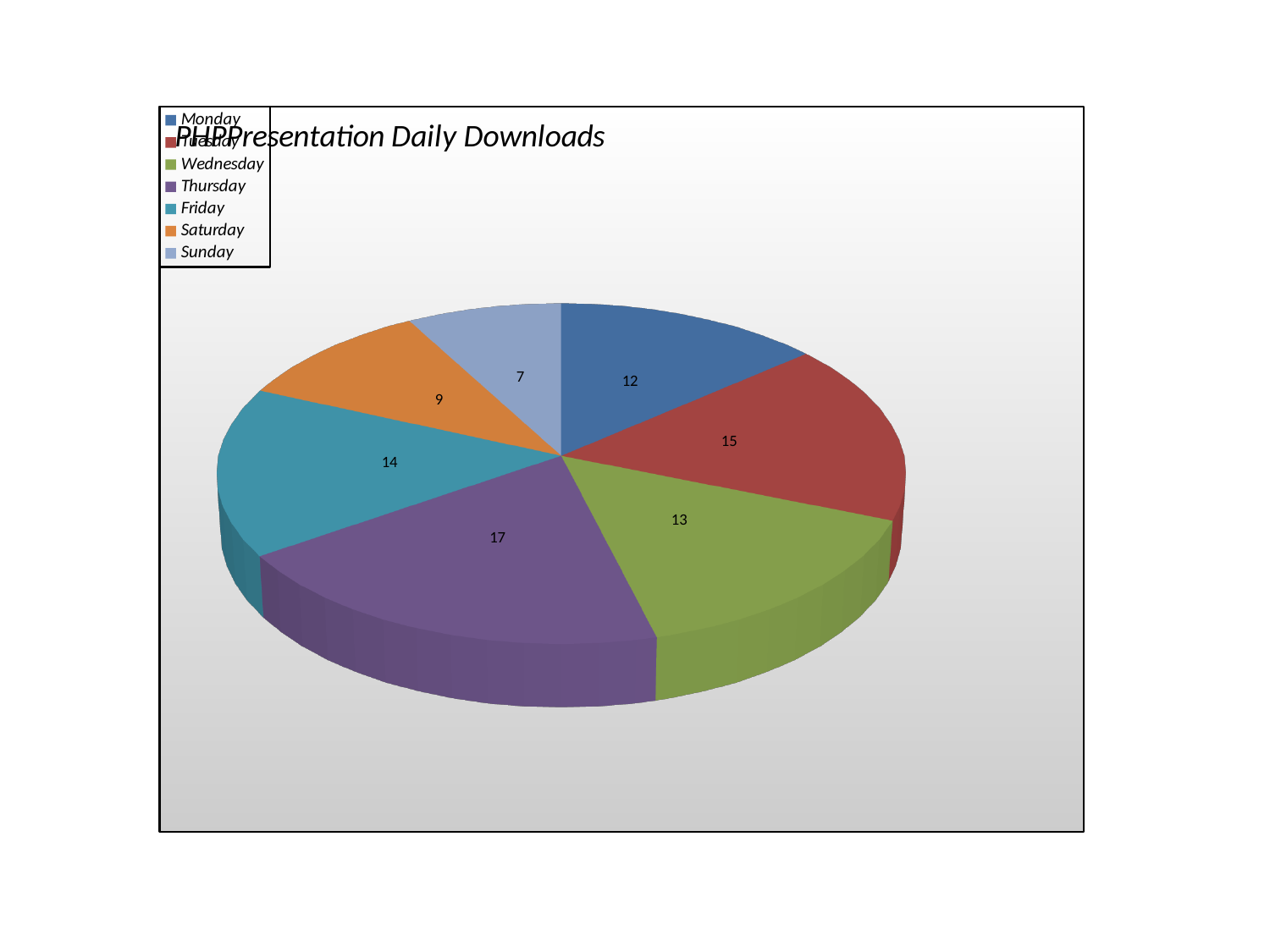
Which day has the largest slice of the pie? Thursday What is the difference between the values for Thursday and Sunday? 10 What is the value for Saturday? 9 What is the value for Thursday? 17 What is the difference between the values for Tuesday and Monday? 3 What is the value for Tuesday? 15 What is the value for Sunday? 7 What type of chart is shown on the slide? Pie chart What is the title of the chart? PHPPresentation Daily Downloads How many slices does the pie chart have? 7 Which day has the smallest slice of the pie? Sunday Which is larger, the value for Friday or the value for Wednesday? Friday